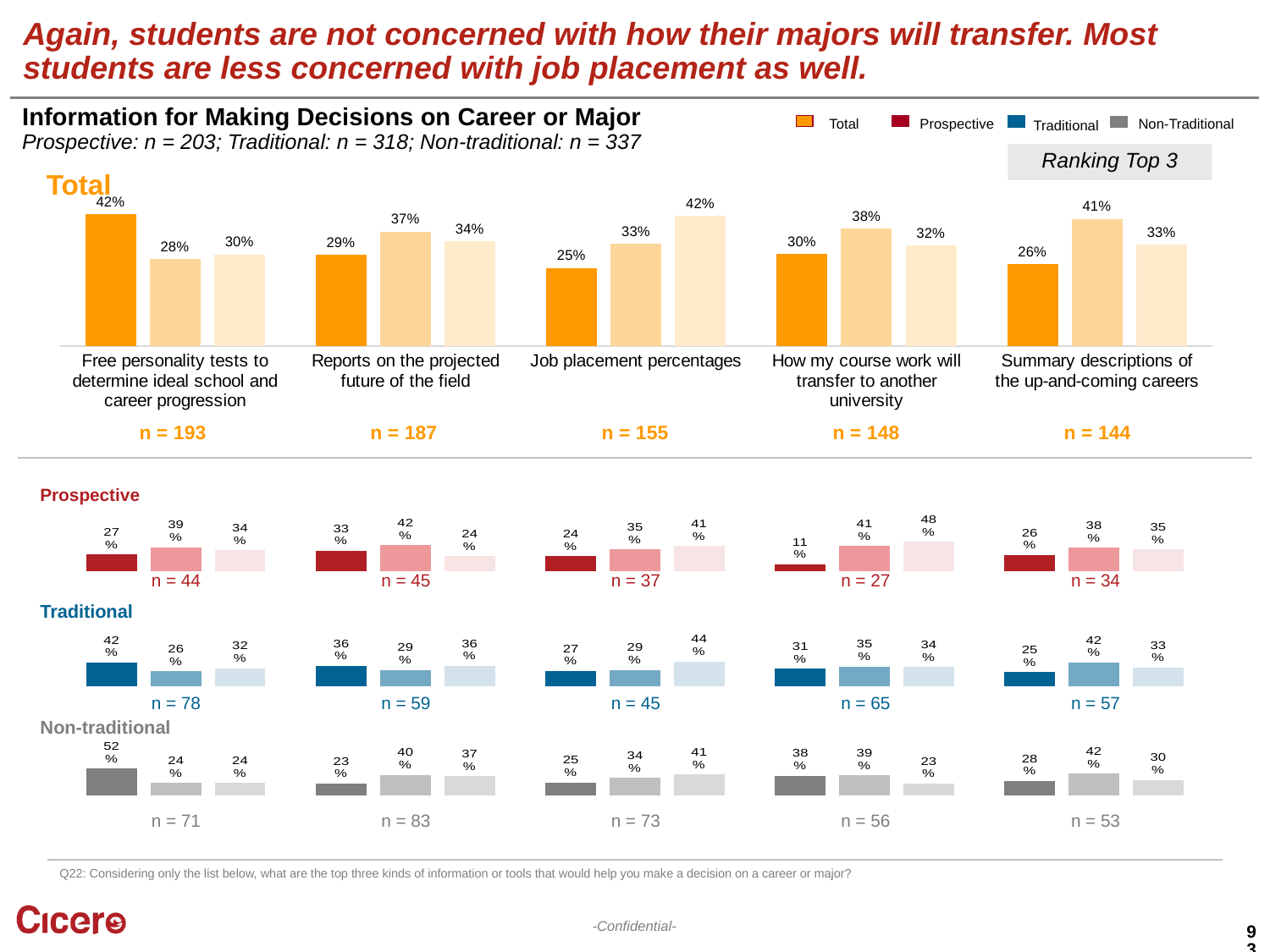
How many entries does the legend at the top right of the slide list? 4 In the Total chart, what is the n value shown under 'Job placement percentages'? n = 155 In the Traditional chart, what is the n value shown under 'Free personality tests to determine ideal school and career progression'? n = 78 In the Total chart, what value is shown on the darkest (leftmost) bar for 'Free personality tests to determine ideal school and career progression'? 42% In the Non-traditional chart, which has the larger darkest-bar value: 'Free personality tests' or 'Reports on the projected future of the field'? Free personality tests In the Total chart, which category has the highest value on its darkest (leftmost) bar? Free personality tests to determine ideal school and career progression How many information categories are shown along the x axis of the Total chart? 5 What type of chart is used to show the Total results? Bar chart In the Prospective chart, what value is shown on the darkest (leftmost) bar for 'How my course work will transfer to another university'? 11% In the Non-traditional chart, what value is shown on the darkest (leftmost) bar for 'Free personality tests to determine ideal school and career progression'? 52% In the Prospective chart, which category has the lowest value on its darkest (leftmost) bar? How my course work will transfer to another university In the Total chart, what is the difference between the darkest-bar values for 'Free personality tests' (42%) and 'Job placement percentages' (25%)? 17 percentage points